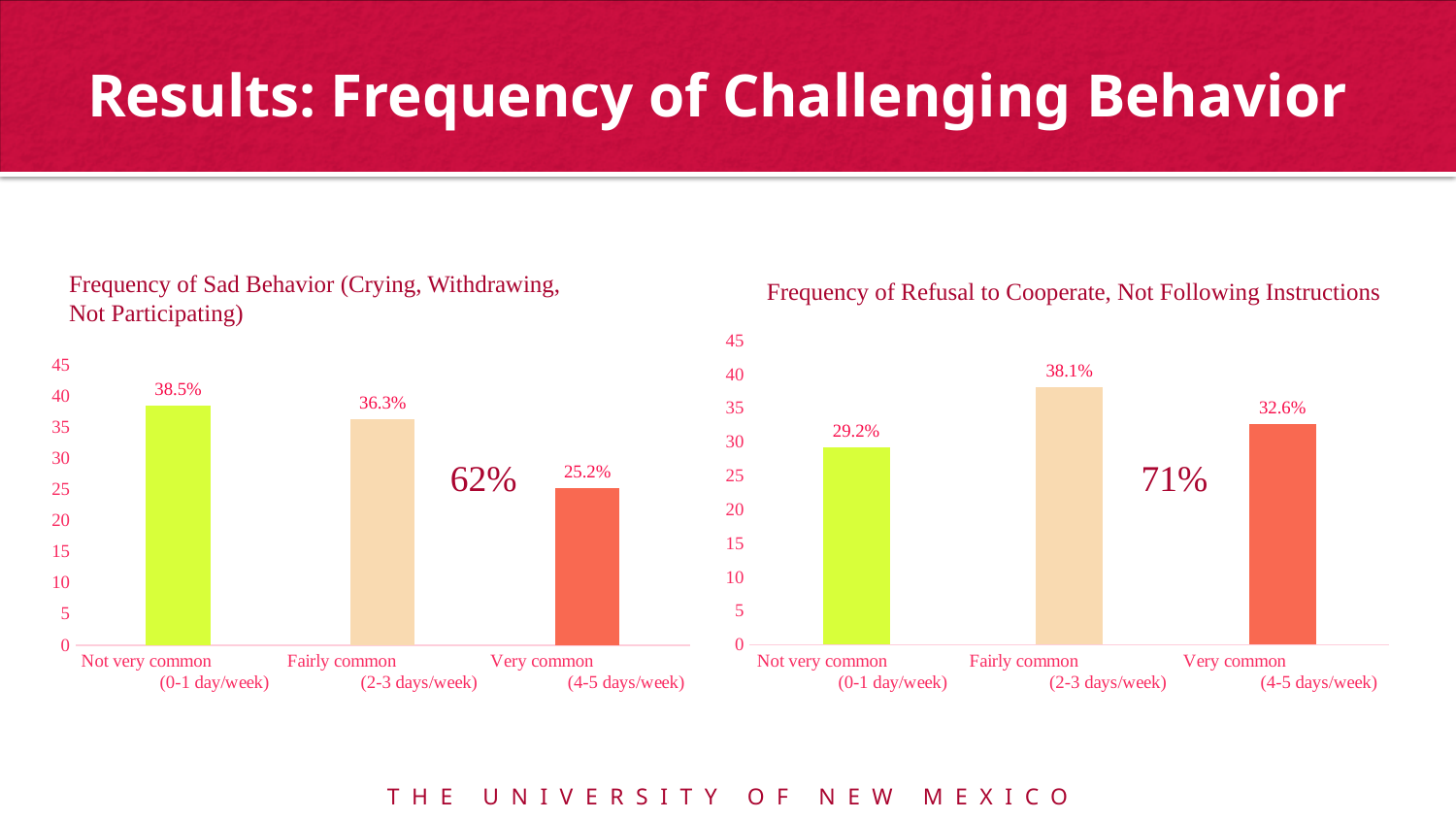
In the 'Frequency of Sad Behavior' chart, what is the value for 'Very common'? 25.2% In the 'Frequency of Refusal to Cooperate, Not Following Instructions' chart, what is the value for 'Not very common'? 29.2% In the 'Frequency of Sad Behavior' chart, do the values rise or fall from left to right? Fall What kind of chart is the 'Frequency of Refusal to Cooperate, Not Following Instructions' chart? Bar chart How many categories are shown in the 'Frequency of Sad Behavior' chart? 3 In the 'Frequency of Refusal to Cooperate, Not Following Instructions' chart, which is larger: 'Very common' or 'Not very common'? Very common In the 'Frequency of Sad Behavior' chart, what is the difference between 'Not very common' and 'Very common'? 13.3% In the 'Frequency of Sad Behavior' chart, which category has the highest value? Not very common In the 'Frequency of Refusal to Cooperate, Not Following Instructions' chart, which category has the lowest value? Not very common In the 'Frequency of Sad Behavior' chart, what is the value for 'Not very common'? 38.5% In the 'Frequency of Refusal to Cooperate, Not Following Instructions' chart, what is the value for 'Fairly common'? 38.1% In the 'Frequency of Refusal to Cooperate, Not Following Instructions' chart, what is the difference between 'Fairly common' and 'Very common'? 5.5%